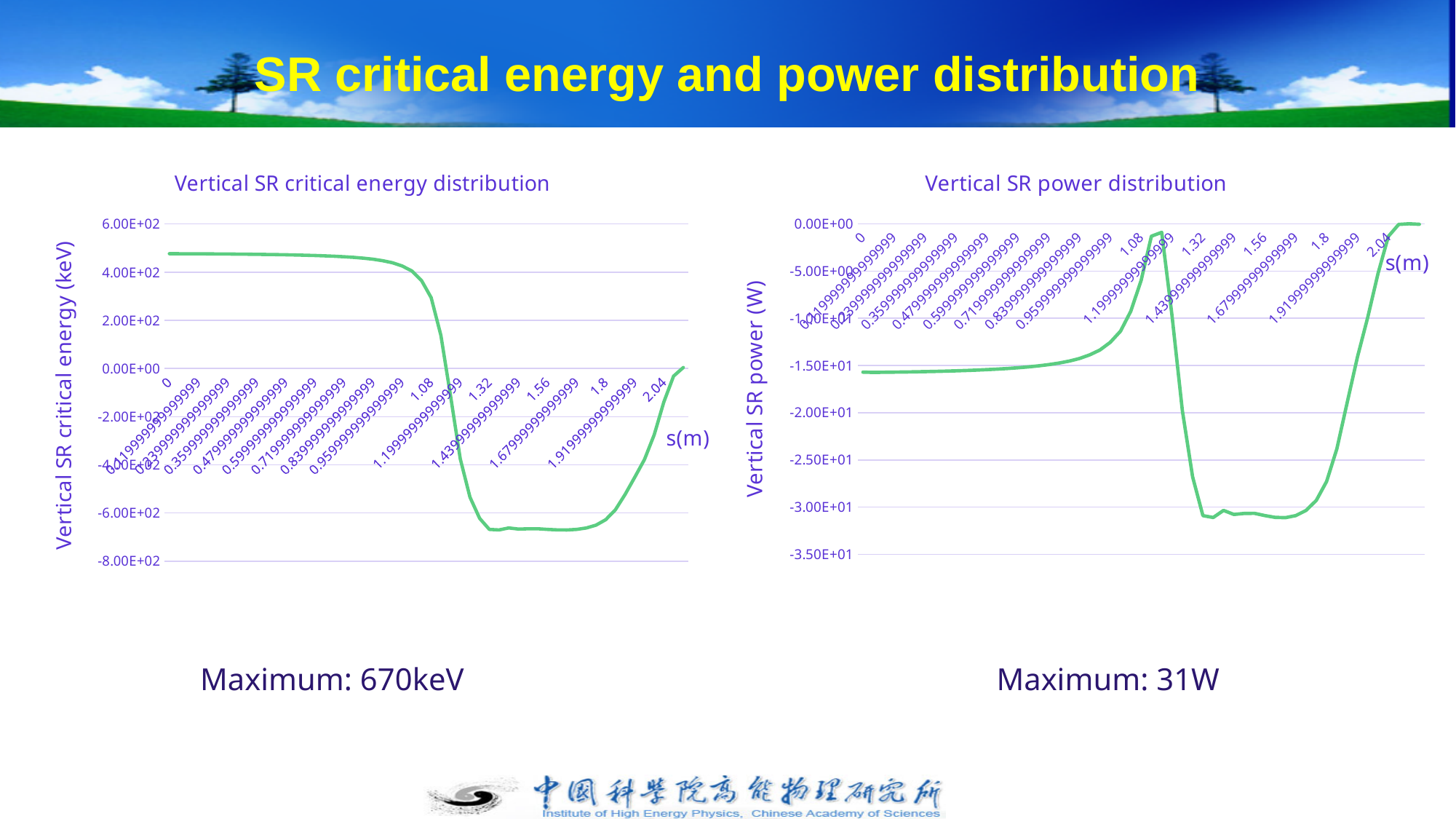
How many charts are shown on the slide? 2 In the 'Vertical SR power distribution' chart, is the value at s = 0 greater or less than -2.00E+01? greater In the 'Vertical SR power distribution' chart, does the line rise or fall between s = 0 and s = 1.08? rise In the 'Vertical SR critical energy distribution' chart, is the value at s = 0 greater or less than 4.00E+02? greater In the 'Vertical SR critical energy distribution' chart, does the line rise or fall between s = 1.08 and s = 1.32? fall In the 'Vertical SR critical energy distribution' chart, is the value at s = 1.56 greater or less than -6.00E+02? less In the 'Vertical SR power distribution' chart, what is the label of the x axis? s(m) What kind of chart is the 'Vertical SR critical energy distribution' chart? line chart What kind of chart is the 'Vertical SR power distribution' chart? line chart In the 'Vertical SR critical energy distribution' chart, what is the label of the y axis? Vertical SR critical energy (keV)